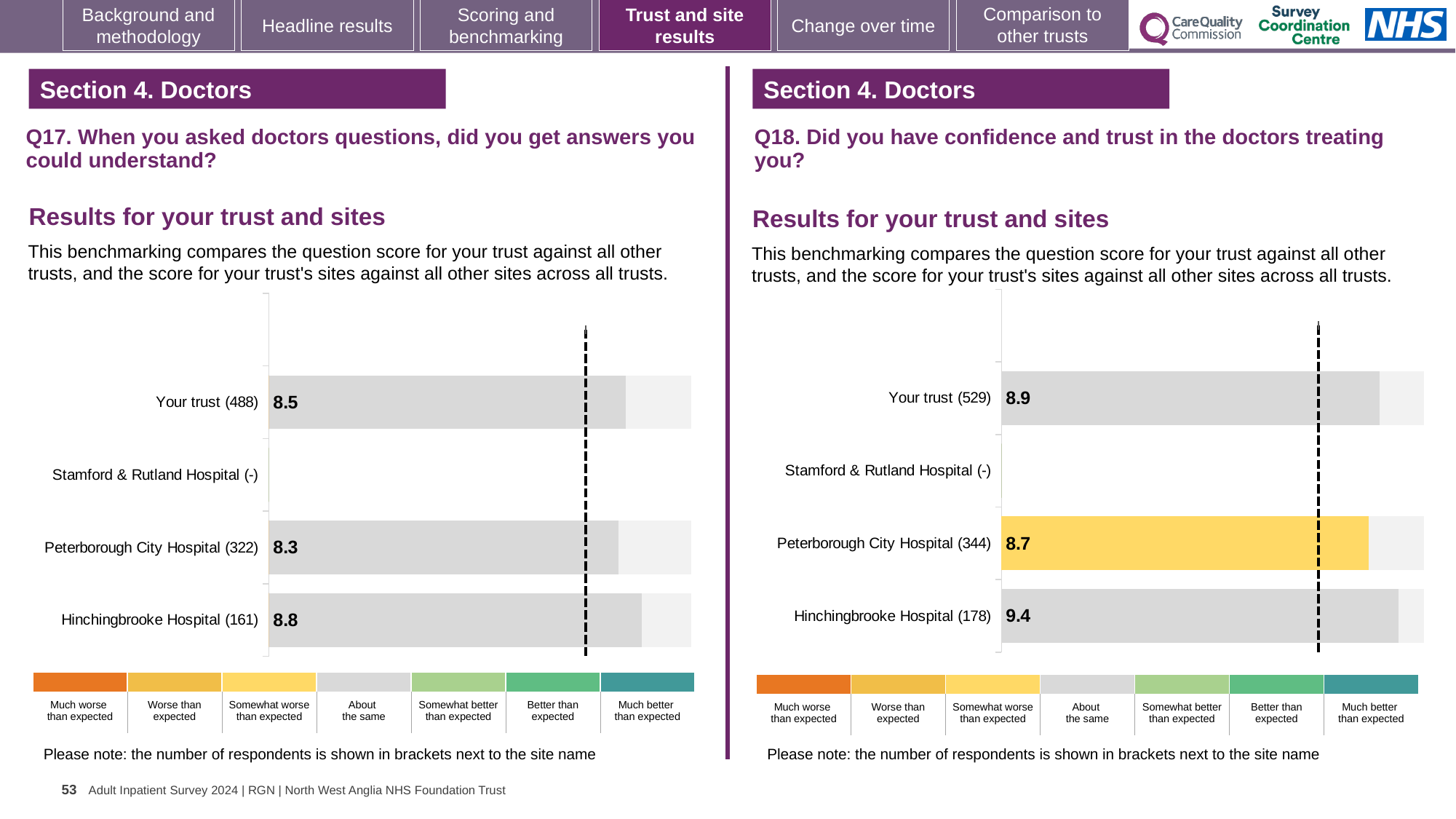
On the Q17 chart (left), which site has the lowest score? Peterborough City Hospital (322) On the Q18 chart (right), what is the score for Peterborough City Hospital (344)? 8.7 On the Q18 chart (right), which site has the highest score? Hinchingbrooke Hospital (178) On the Q18 chart (right), what is the difference between the scores for Hinchingbrooke Hospital and Your trust? 0.5 On the Q18 chart (right), what is the score for Your trust (529)? 8.9 On the Q18 chart (right), which benchmark category does the colour of the Peterborough City Hospital bar indicate? Somewhat worse than expected On the Q17 chart (left), what is the score for Hinchingbrooke Hospital (161)? 8.8 What type of chart is used on the Q18 chart (right)? Bar chart On the Q17 chart (left), what is the score for Your trust (488)? 8.5 How many categories (rows) are listed on the Q17 chart (left)? 4 On the Q17 chart (left), what is the difference between the scores for Hinchingbrooke Hospital and Peterborough City Hospital? 0.5 On the Q18 chart (right), which has the larger score, Your trust or Peterborough City Hospital? Your trust